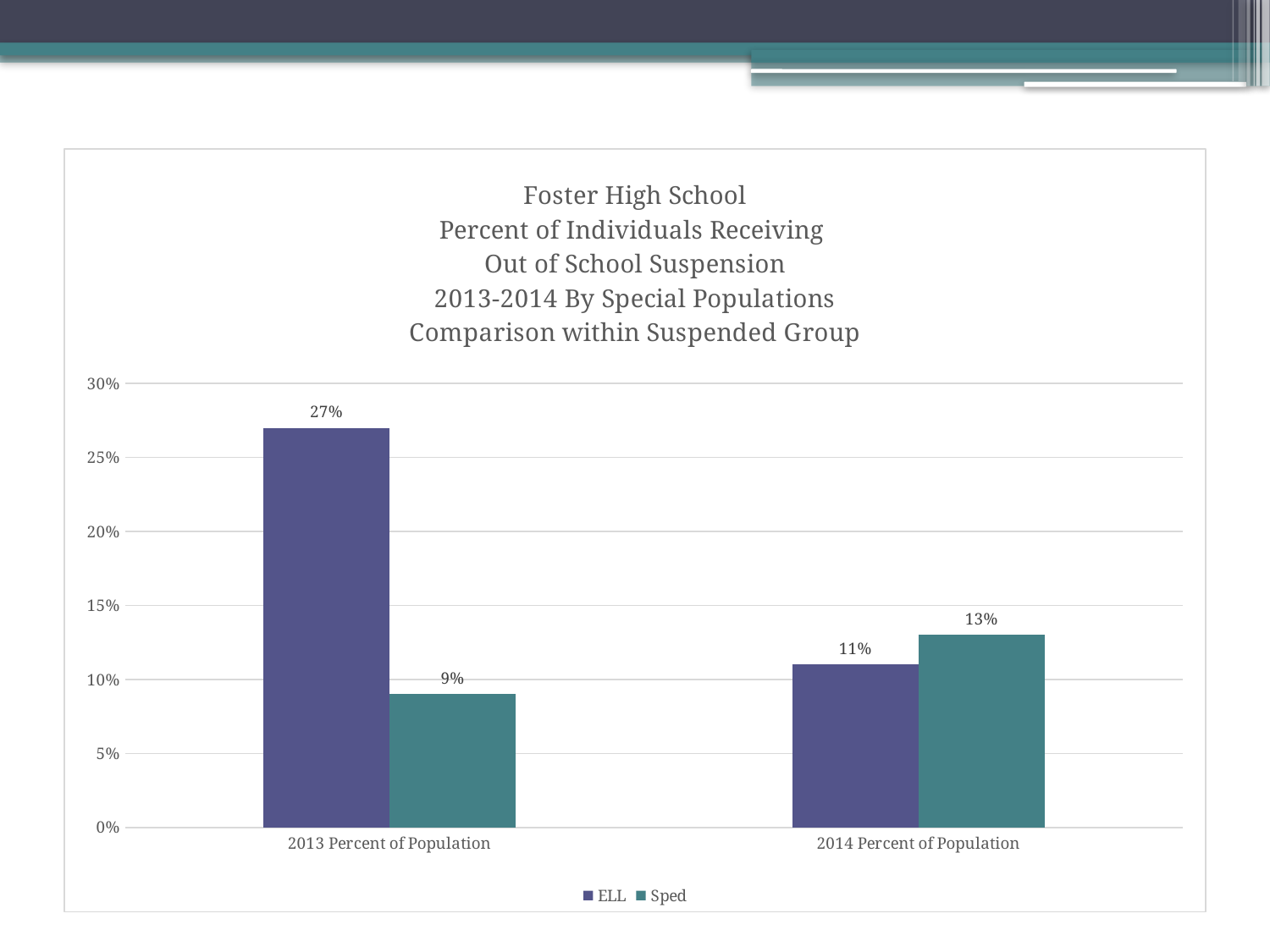
Which is larger in 2014 Percent of Population, ELL or Sped? Sped Which bar has the highest value on the chart? ELL, 2013 Percent of Population What is the difference between the ELL values for 2013 and 2014? 16% Is the Sped value for 2014 Percent of Population greater or less than 10%? greater What is the Sped value for 2014 Percent of Population? 13% Which bar has the lowest value on the chart? Sped, 2013 Percent of Population What is the ELL value for 2013 Percent of Population? 27% What is the ELL value for 2014 Percent of Population? 11% What kind of chart is shown on the slide? Bar chart How many series does the legend list? 2 Does the ELL series rise or fall from 2013 to 2014? Fall What is the Sped value for 2013 Percent of Population? 9%